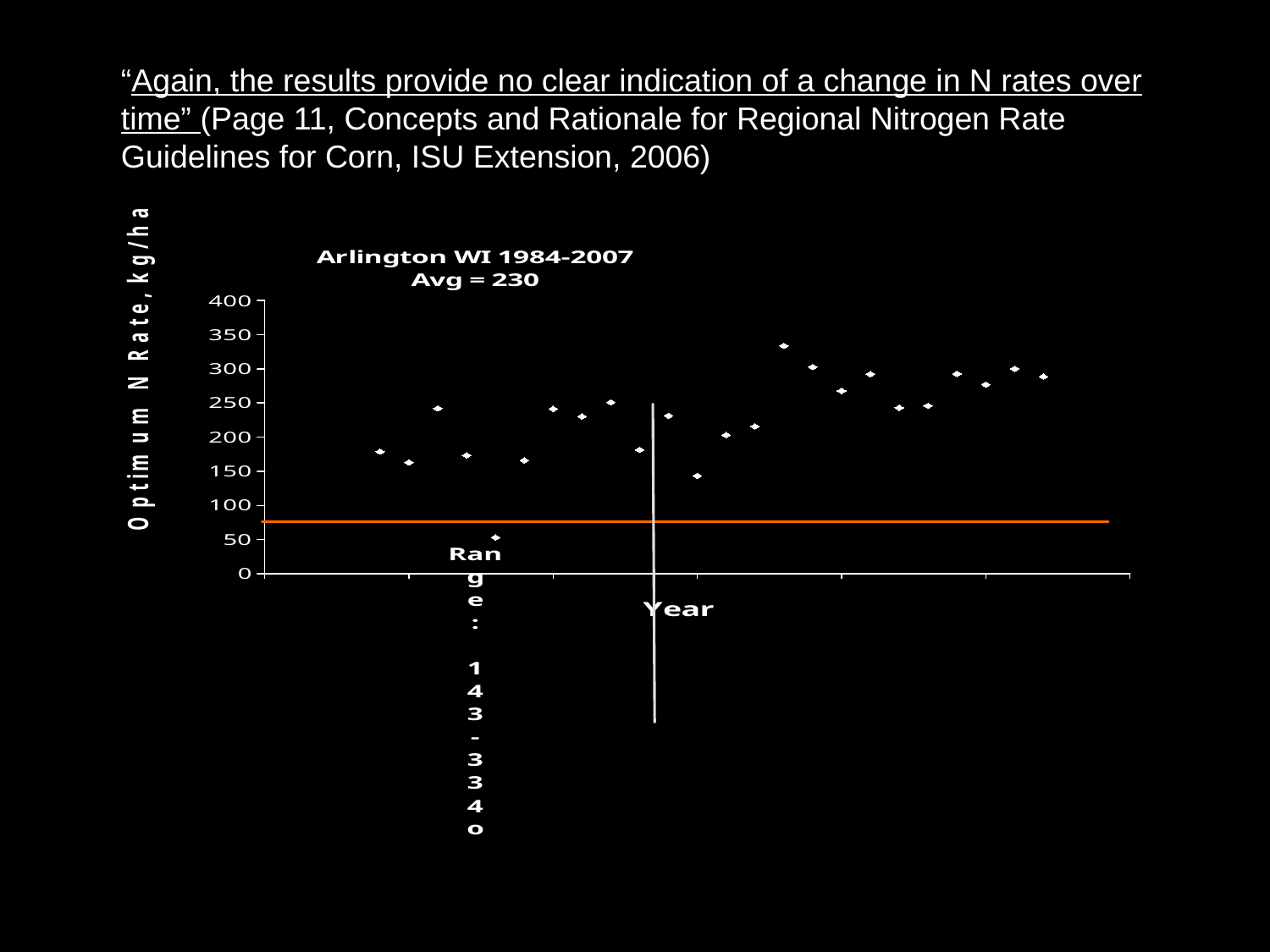
Is the highest plotted point greater or less than 300? greater What is the label of the y axis? Optimum N Rate, kg/ha What range of values is printed on the chart? 143-334 Is the highest plotted point greater or less than 350? less What average value is stated in the chart title? 230 What is the maximum value shown on the y axis? 400 What is the label of the x axis? Year What kind of chart is shown on the slide? scatter chart Is the lowest plotted point greater or less than 150? less